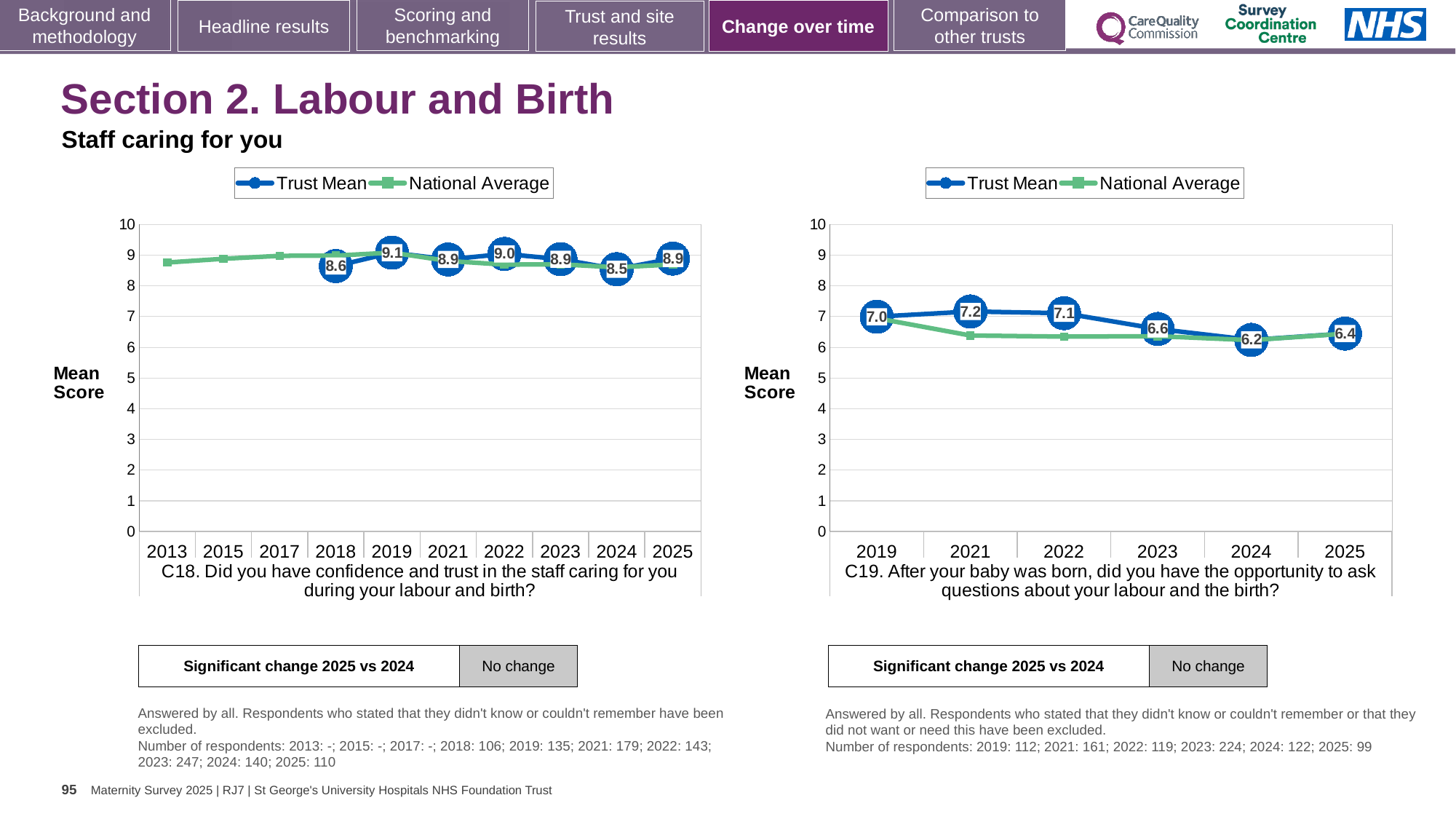
In the right chart (C19), how many series does the legend list? 2 In the right chart (C19), is the National Average for 2021 greater or less than 7? less In the left chart (C18), what is the difference between the Trust Mean for 2019 and 2024? 0.6 What kind of chart is the right chart (C19)? Line chart In the left chart (C18), what is the Trust Mean for 2024? 8.5 In the left chart (C18), which year has the lowest Trust Mean? 2024 In the right chart (C19), which year has the lowest Trust Mean? 2024 In the right chart (C19), what is the Trust Mean for 2021? 7.2 In the left chart (C18), what is the Trust Mean for 2019? 9.1 In the left chart (C18), which year has the highest Trust Mean? 2019 In the left chart (C18), how many years are shown on the x axis? 10 In the right chart (C19), is the Trust Mean for 2025 greater or less than the Trust Mean for 2022? less